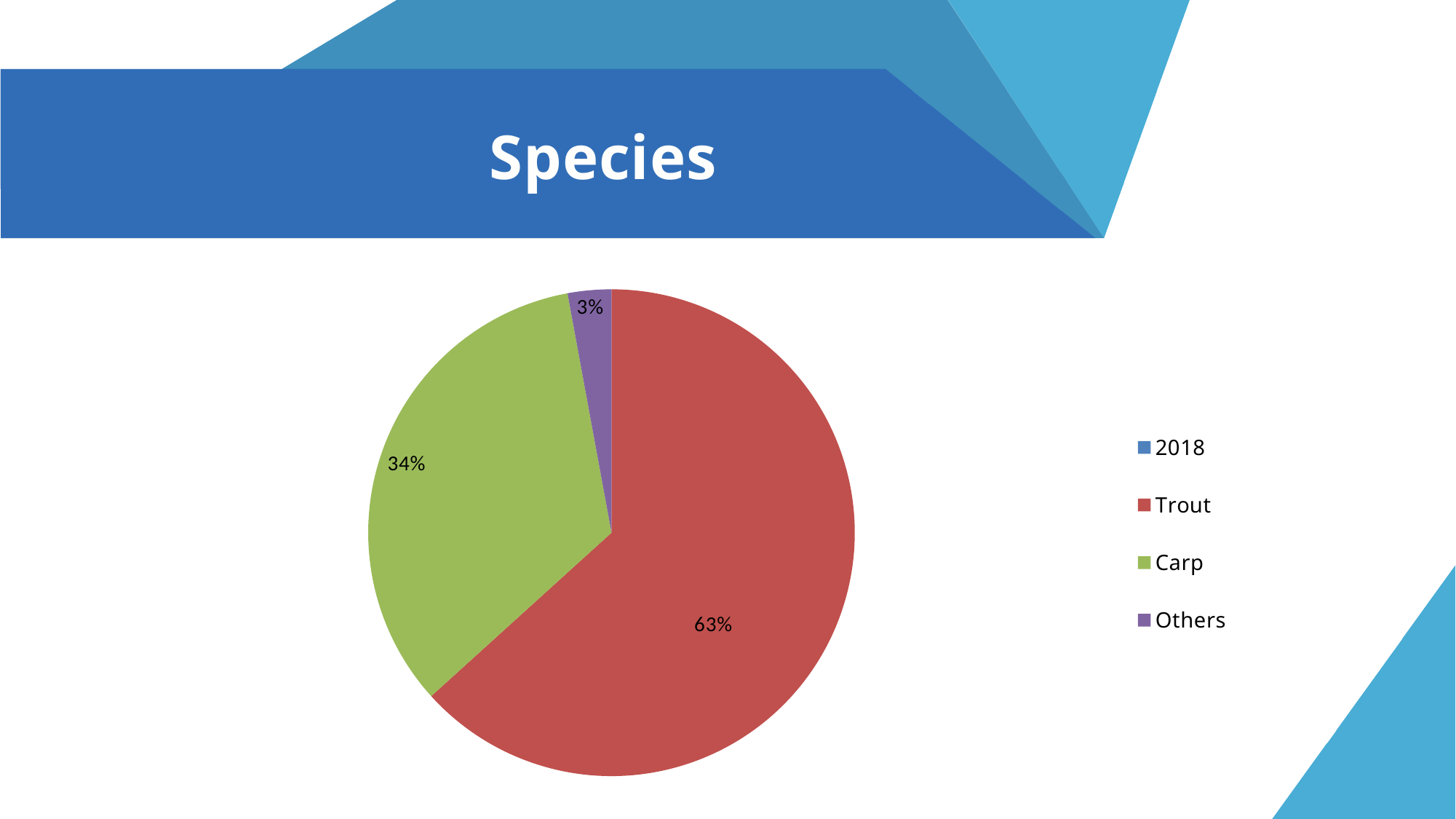
How many entries does the legend list? 4 How many slices are visible in the pie chart? 3 Which is larger, the share for Carp or the share for Others? Carp What percentage of the pie does Carp account for? 34% What is the difference in percentage points between the Trout and Carp shares? 29 What is the title of the slide containing the pie chart? Species Which species has the largest share of the pie? Trout What type of chart is shown on the slide? pie chart Which labelled slice has the smallest share of the pie? Others What colour is the Carp slice in the pie chart? green What percentage of the pie does Trout account for? 63% What percentage of the pie does Others account for? 3%